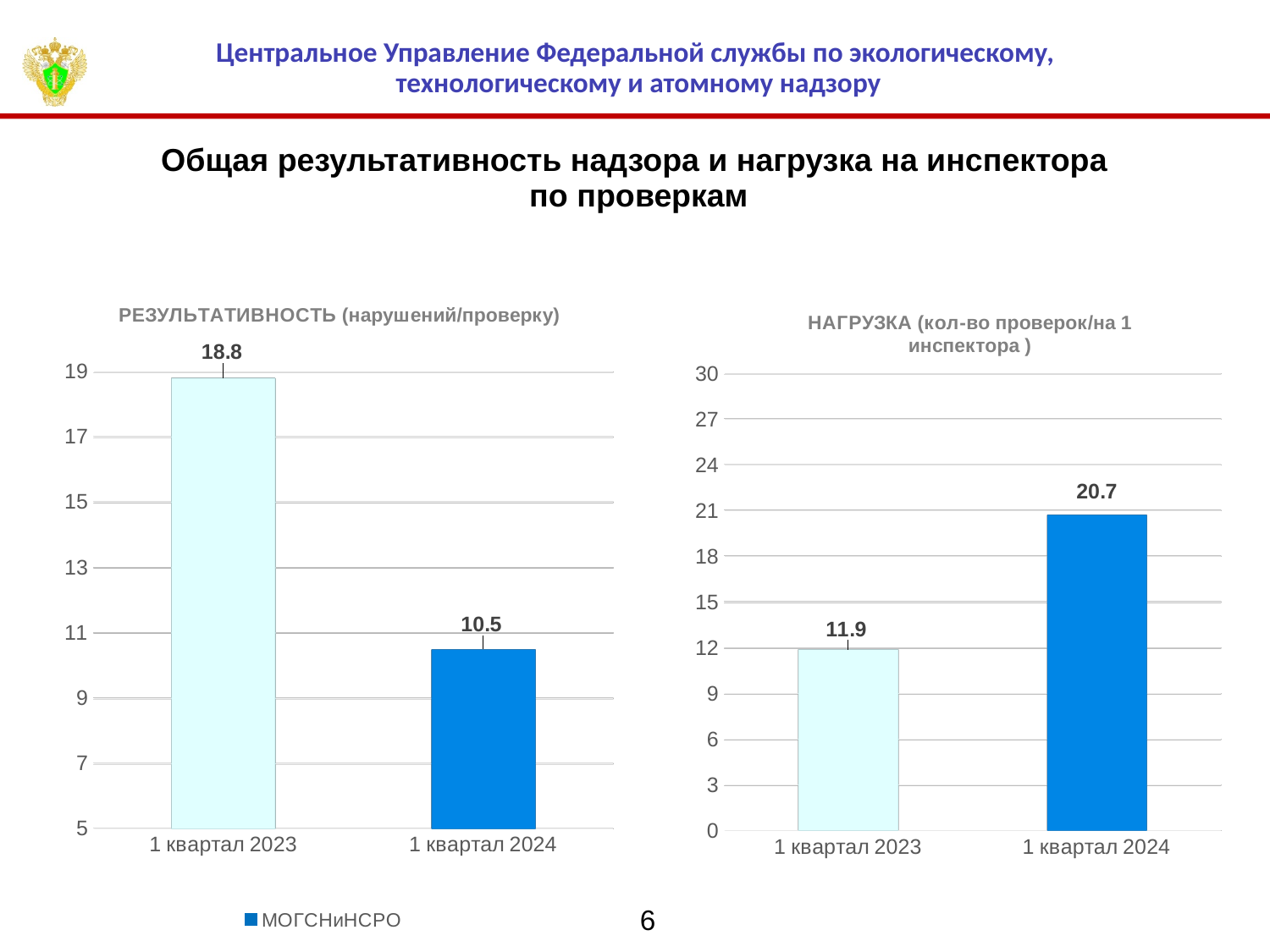
In the РЕЗУЛЬТАТИВНОСТЬ chart, what is the difference between the values for 1 квартал 2023 and 1 квартал 2024? 8.3 In the РЕЗУЛЬТАТИВНОСТЬ chart, which category has the highest value? 1 квартал 2023 In the НАГРУЗКА chart, is the value for 1 квартал 2024 greater or less than 18? greater What kind of chart is the НАГРУЗКА chart on the right? bar chart In the РЕЗУЛЬТАТИВНОСТЬ chart, do the values rise or fall from 1 квартал 2023 to 1 квартал 2024? fall How many categories are shown in the РЕЗУЛЬТАТИВНОСТЬ chart? 2 In the НАГРУЗКА (кол-во проверок/на 1 инспектора) chart, what is the value for 1 квартал 2023? 11.9 In the НАГРУЗКА chart, what is the difference between the values for 1 квартал 2024 and 1 квартал 2023? 8.8 In the РЕЗУЛЬТАТИВНОСТЬ (нарушений/проверку) chart, what is the value for 1 квартал 2023? 18.8 In the РЕЗУЛЬТАТИВНОСТЬ (нарушений/проверку) chart, what is the value for 1 квартал 2024? 10.5 In the НАГРУЗКА (кол-во проверок/на 1 инспектора) chart, what is the value for 1 квартал 2024? 20.7 In the НАГРУЗКА chart, which category has the lowest value? 1 квартал 2023